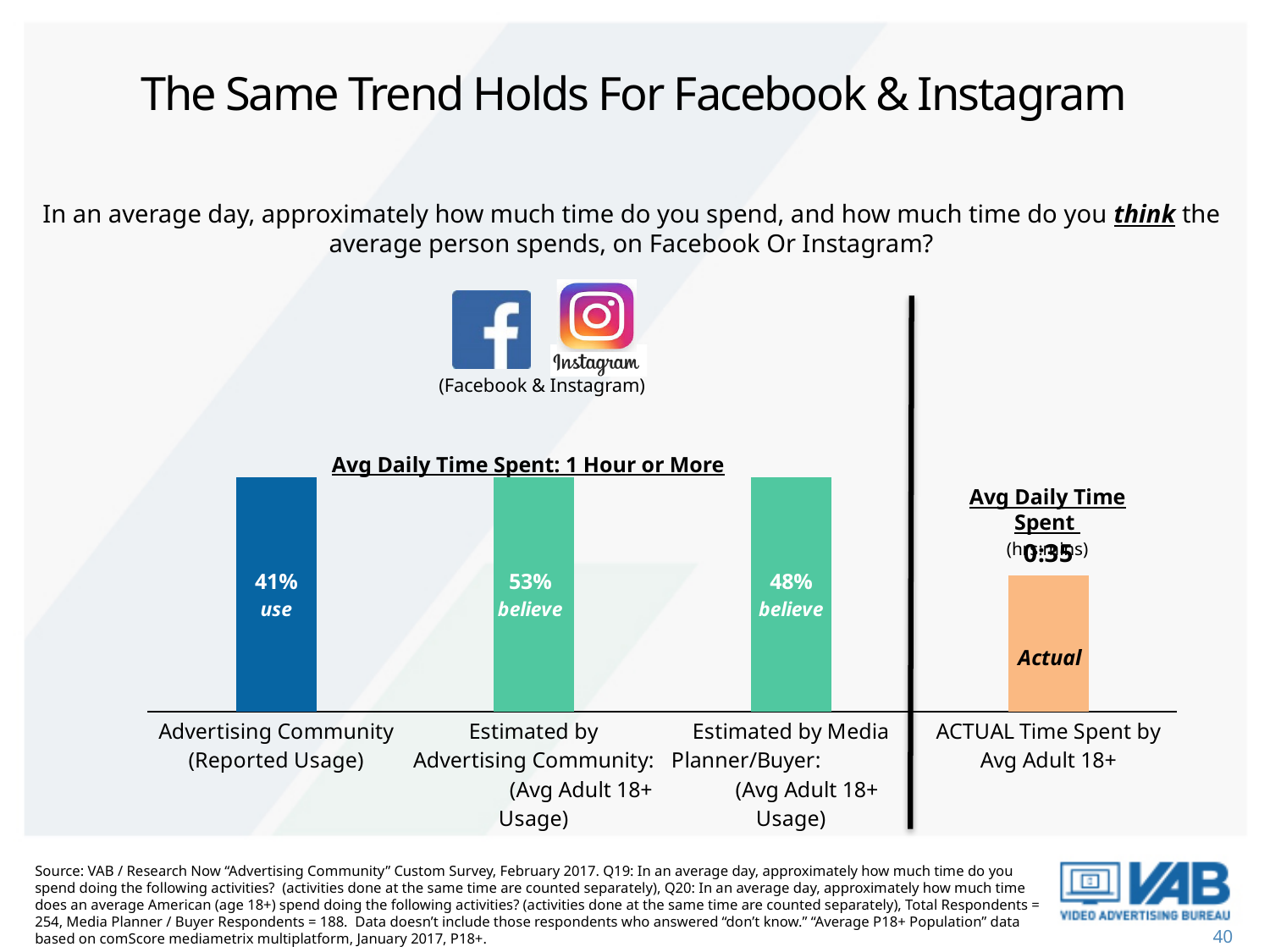
What is the title above the three percentage bars? Avg Daily Time Spent: 1 Hour or More What kind of chart is shown on the slide? Bar chart Which of the three percentage bars has the lowest value? Advertising Community (Reported Usage) Which of the three percentage bars has the highest value? Estimated by Advertising Community What percentage is shown for Estimated by Advertising Community (Avg Adult 18+ Usage)? 53% Which is larger: the Estimated by Media Planner/Buyer value or the Advertising Community (Reported Usage) value? Estimated by Media Planner/Buyer What percentage is shown for Estimated by Media Planner/Buyer (Avg Adult 18+ Usage)? 48% What percentage is shown for Advertising Community (Reported Usage) in the Avg Daily Time Spent: 1 Hour or More chart? 41% What is the difference between the Estimated by Advertising Community value and the Advertising Community (Reported Usage) value? 12 percentage points Which bar is coloured dark blue? Advertising Community (Reported Usage) What is the difference between the Estimated by Advertising Community value and the Estimated by Media Planner/Buyer value? 5 percentage points How many bars are plotted on the slide in total? 4